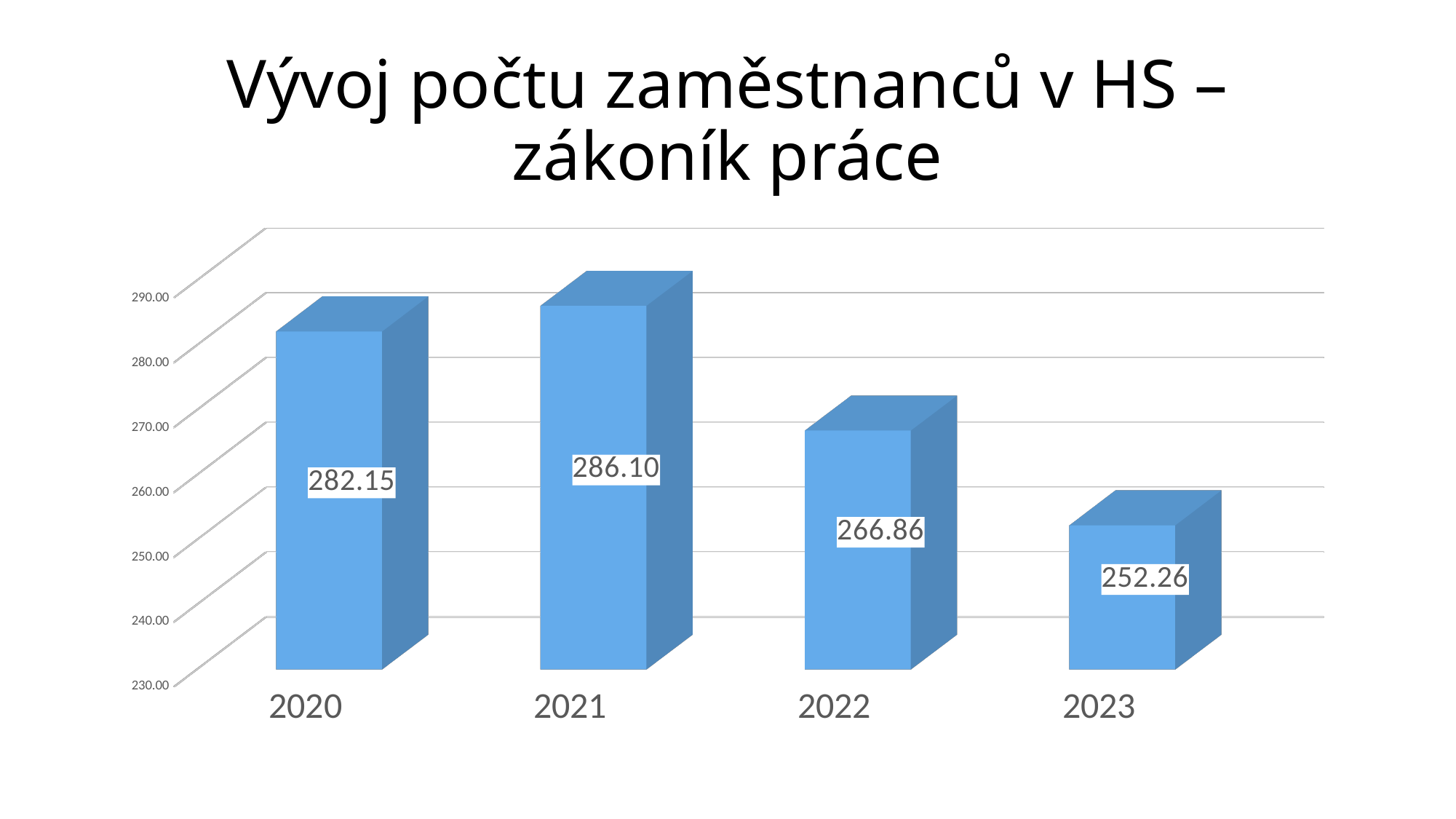
Which is larger, the value for 2022 or the value for 2023? 2022 What is the value for 2022? 266.86 Which year has the lowest value? 2023 From 2021 to 2023, do the values rise or fall? Fall How many years are shown on the x axis? 4 What kind of chart is shown on the slide? Bar chart What is the difference between the values for 2020 and 2023? 29.89 What is the value for 2023? 252.26 Which year has the highest value? 2021 What is the value for 2021? 286.10 What is the difference between the values for 2021 and 2020? 3.95 What is the value for 2020? 282.15